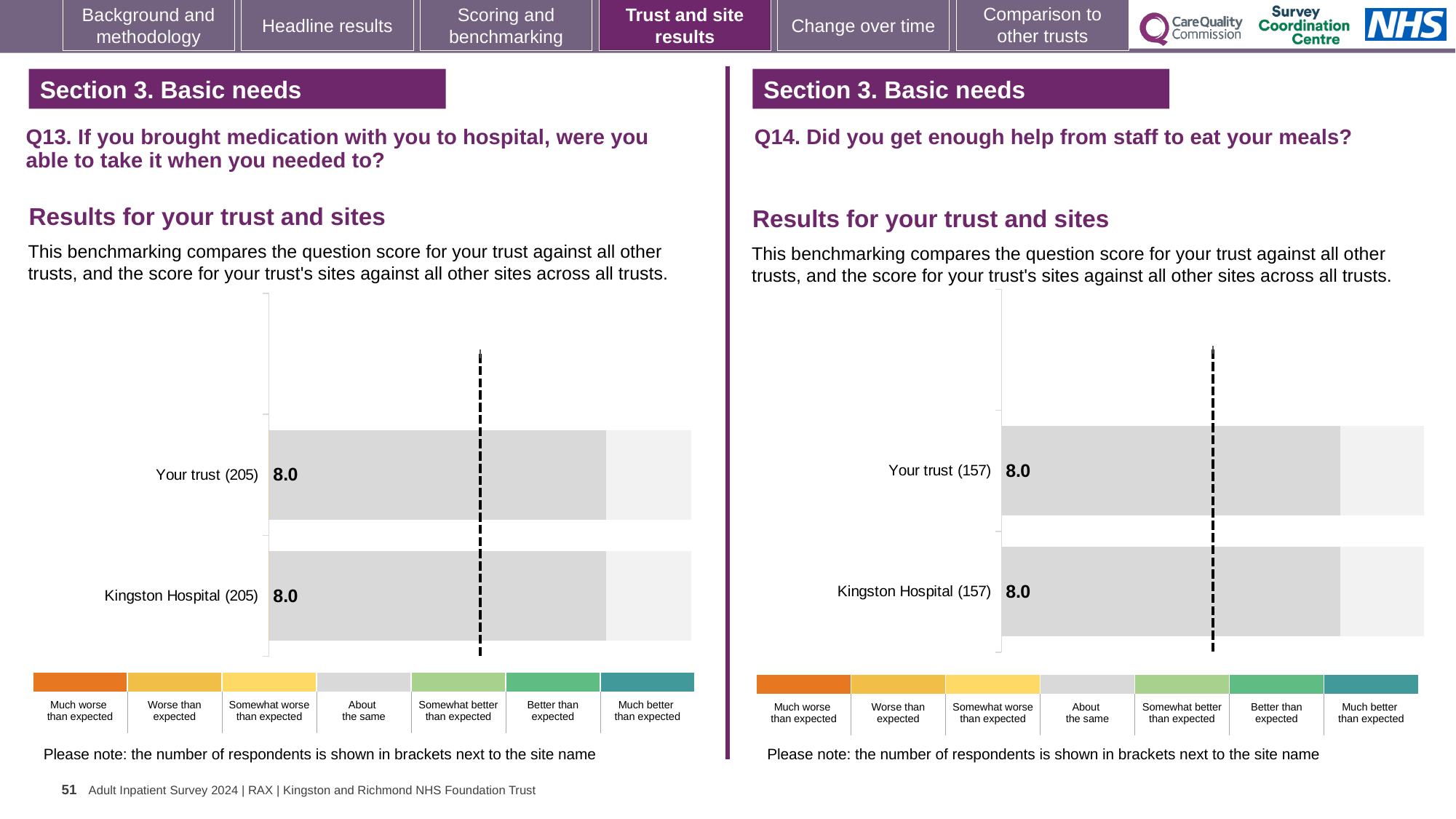
On the right chart (Q14), what is the difference between the Your trust score and the Kingston Hospital score? 0.0 On the left chart (Q13), how many respondents are shown in brackets for Your trust? 205 On the left chart (Q13), what is the difference between the Your trust score and the Kingston Hospital score? 0.0 On the left chart (Q13), what is the score for Your trust? 8.0 On the right chart (Q14), what is the score for Your trust? 8.0 On the left chart (Q13), what is the score for Kingston Hospital? 8.0 On the right chart (Q14), how many respondents are shown in brackets for Kingston Hospital? 157 On the right chart (Q14), which category has the higher score, Your trust or Kingston Hospital? They are equal (both 8.0) On the right chart (Q14), what is the score for Kingston Hospital? 8.0 How many bars are plotted on the left chart (Q13)? 2 How many bars are plotted on the right chart (Q14)? 2 What kind of chart is used on the left (Q13)? Bar chart